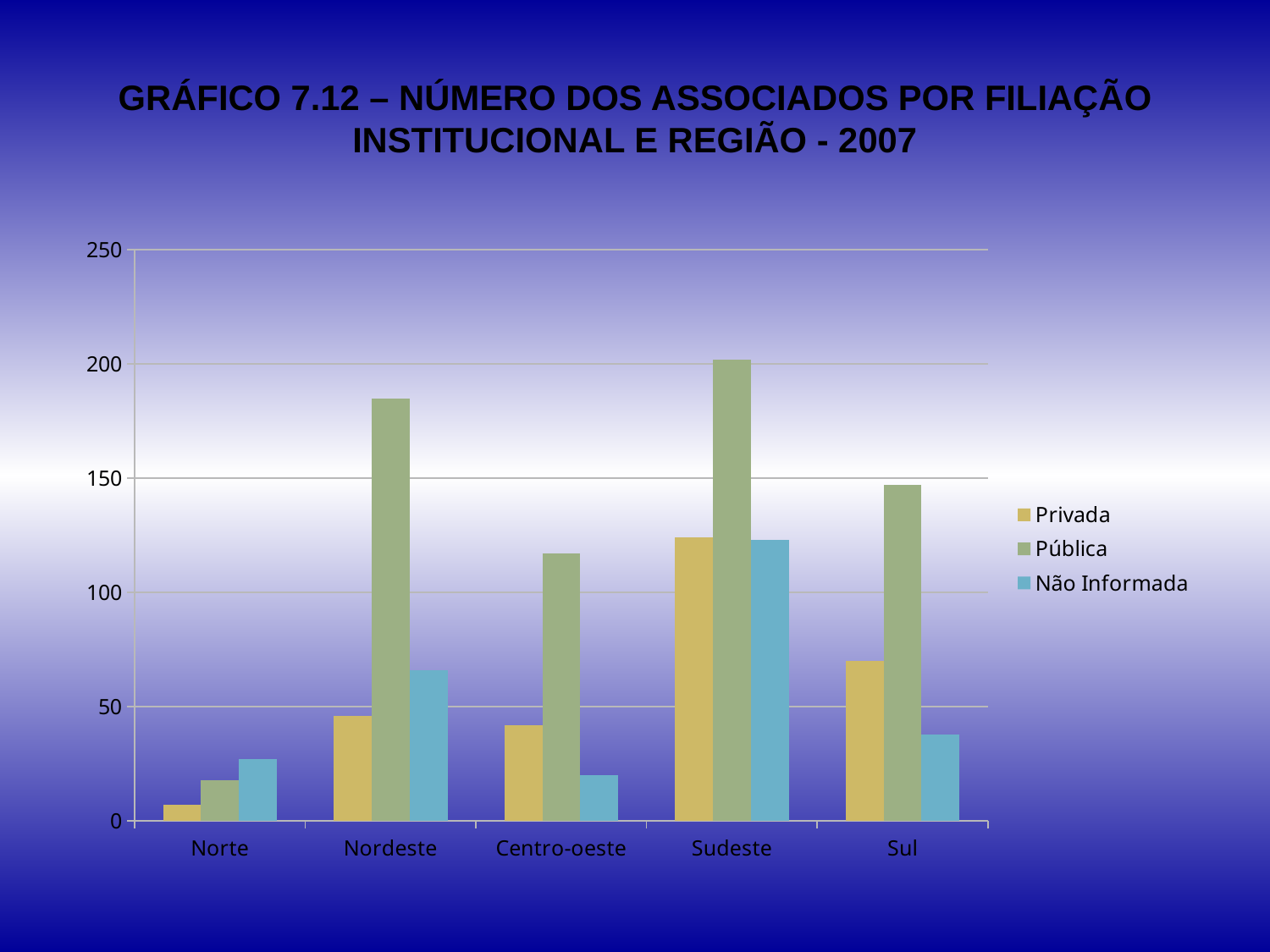
Which region has the lowest value for Privada? Norte Which series is shown in blue in the legend? Não Informada Is the value for Pública in Nordeste greater or less than 150? greater Which region has the highest value for Não Informada? Sudeste Which is larger, the Pública value for Nordeste or the Pública value for Sul? Nordeste Is the value for Pública in Norte greater or less than 50? less How many regions are shown on the x axis? 5 Which region has the highest value for Pública? Sudeste What kind of chart is shown on the slide? bar chart Is the value for Não Informada in Centro-oeste greater or less than 50? less How many series does the legend list? 3